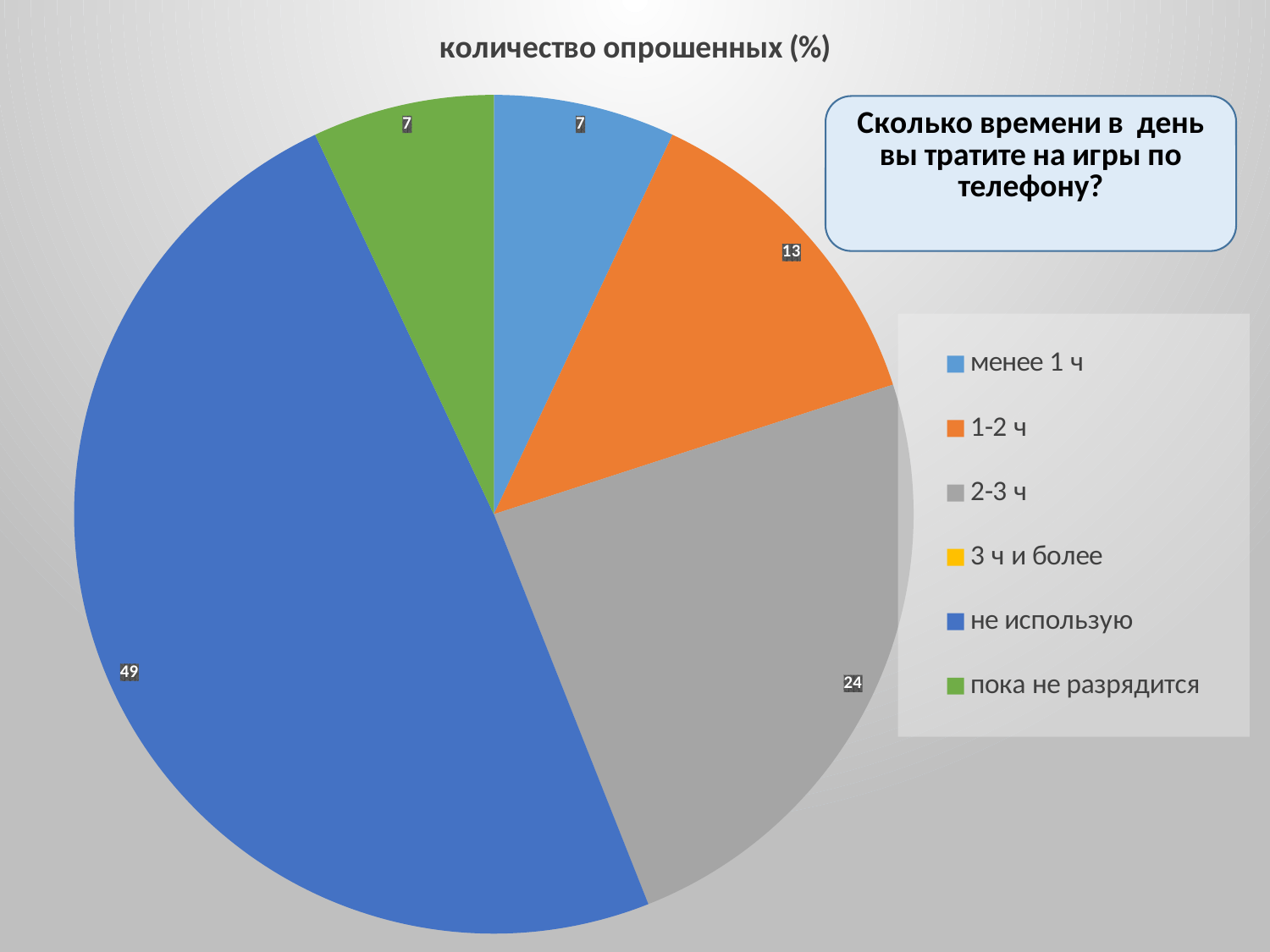
Which is larger, the slice for "2-3 ч" or the slice for "1-2 ч"? 2-3 ч What is the value shown for the "2-3 ч" slice? 24 What is the difference between the values for "не использую" and "2-3 ч"? 25 What is the value shown for the "не использую" slice? 49 What is the value shown for the "менее 1 ч" slice? 7 What is the value shown for the "пока не разрядится" slice? 7 What is the difference between the values for "2-3 ч" and "1-2 ч"? 11 What kind of chart is shown on the slide? pie chart Which category has the largest slice of the pie? не использую What is the value shown for the "1-2 ч" slice? 13 What is the title of the chart? количество опрошенных (%) How many entries does the legend list? 6